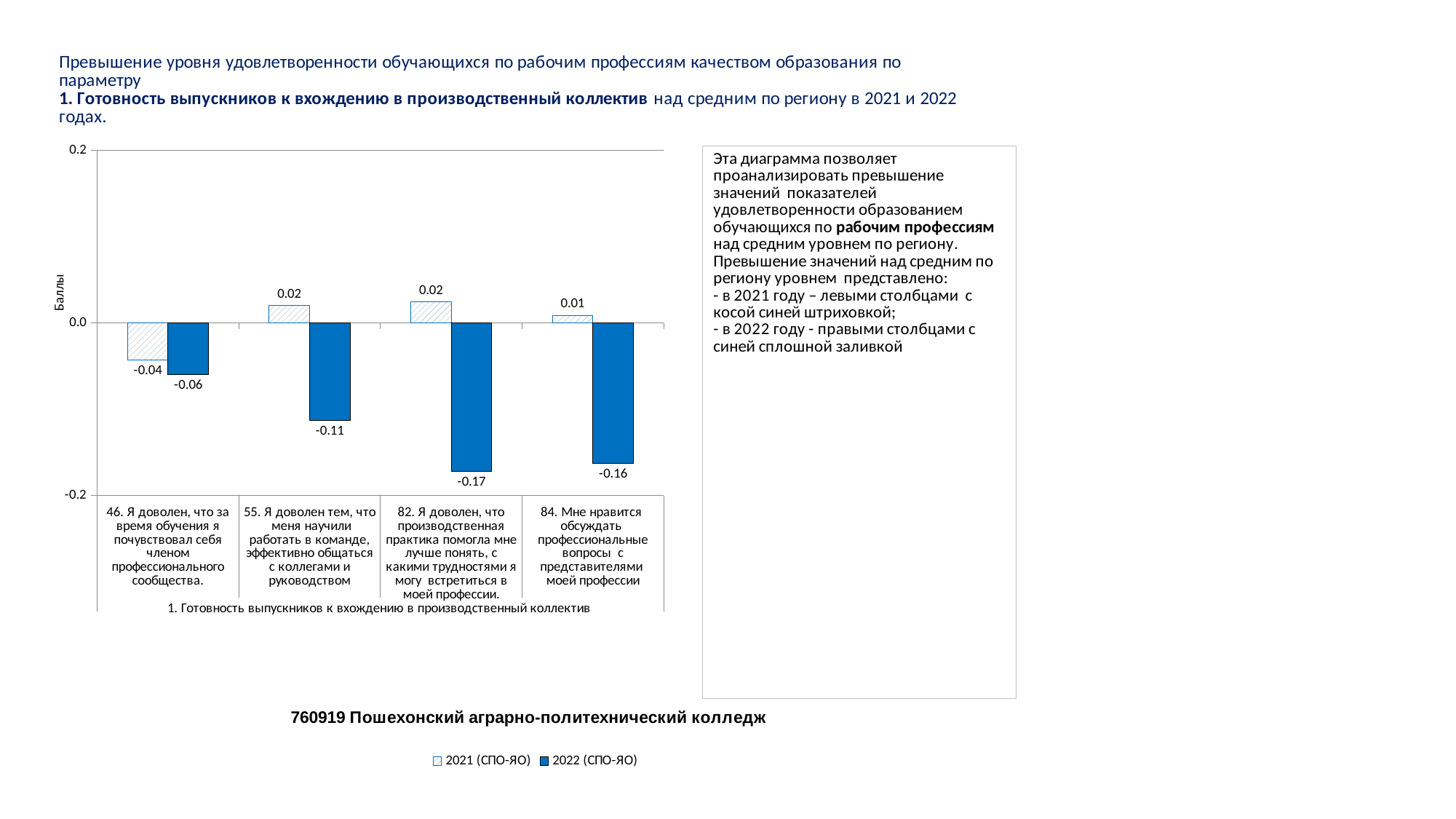
What is the value for 2022 (СПО-ЯО) for category 82 (Я доволен, что производственная практика помогла мне лучше понять...)? -0.17 What is the value for 2021 (СПО-ЯО) for category 46 (Я доволен, что за время обучения я почувствовал себя членом профессионального сообщества)? -0.04 What type of chart is shown on the slide? Bar chart What is the value for 2021 (СПО-ЯО) for category 84 (Мне нравится обсуждать профессиональные вопросы с представителями моей профессии)? 0.01 What is the difference between the 2021 and 2022 values for category 46? 0.02 How many categories are shown on the x axis of the chart? 4 Which category has the lowest value for the 2021 (СПО-ЯО) series? 46. Я доволен, что за время обучения я почувствовал себя членом профессионального сообщества. Which category has the lowest value for the 2022 (СПО-ЯО) series? 82. Я доволен, что производственная практика помогла мне лучше понять, с какими трудностями я могу встретиться в моей профессии. Which is larger for category 84: the 2021 (СПО-ЯО) value or the 2022 (СПО-ЯО) value? 2021 (СПО-ЯО) What is the difference between the 2021 and 2022 values for category 82? 0.19 What is the value for 2022 (СПО-ЯО) for category 55 (Я доволен тем, что меня научили работать в команде)? -0.11 How many series does the chart legend list? 2